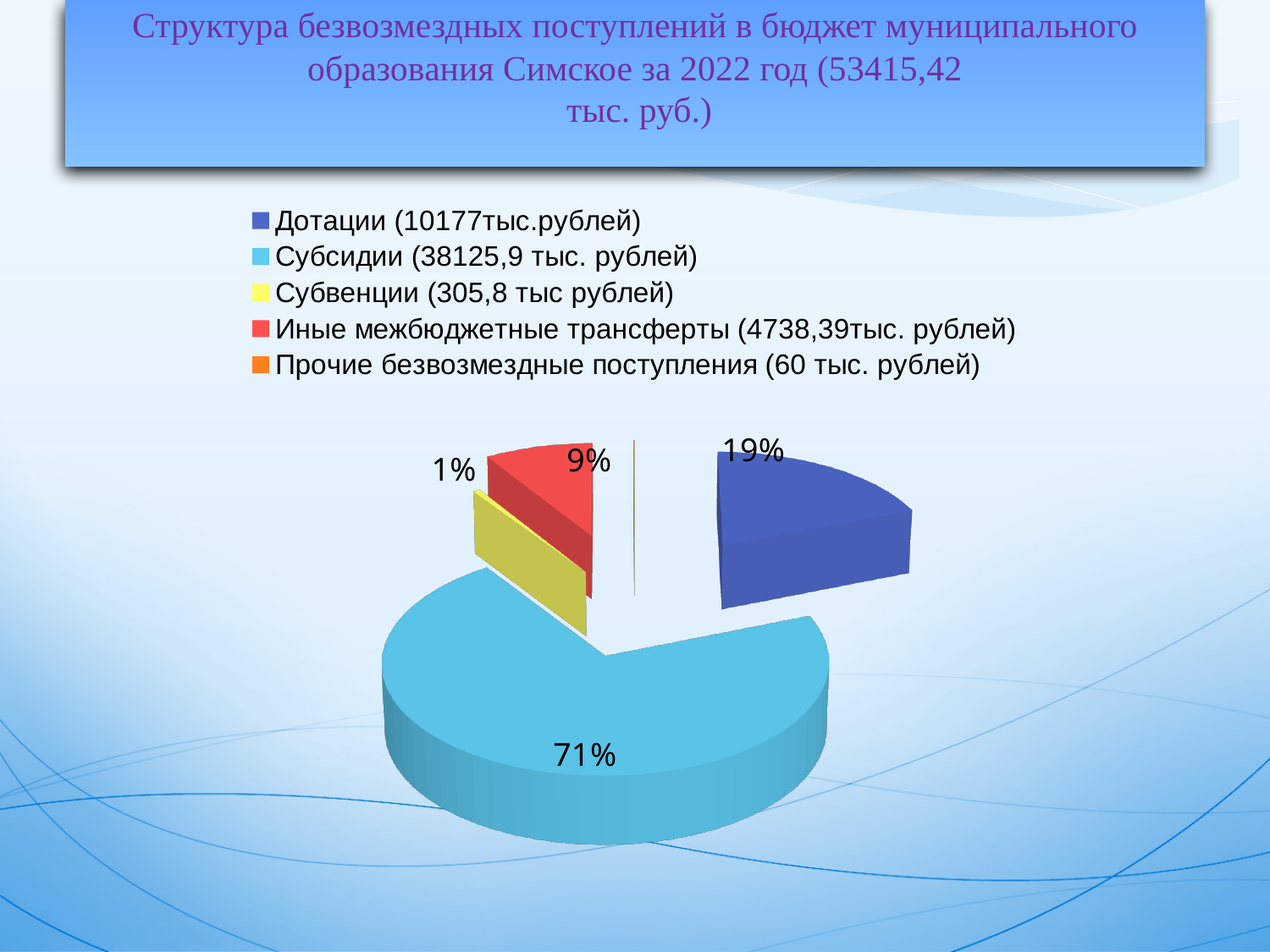
According to the legend, what amount in тыс. рублей corresponds to Субсидии? 38125,9 тыс. рублей What is the difference in percentage points between the Субсидии share and the Дотации share? 52% Which is larger, the share for Дотации or the share for Иные межбюджетные трансферты? Дотации What share of the pie does Дотации account for? 19% What kind of chart is shown on the slide? Pie chart What share of the pie does Субсидии account for? 71% How many categories does the legend list? 5 What total amount is given in the chart title for 2022? 53415,42 тыс. руб. What share of the pie does Субвенции account for? 1% Which category has the smallest value according to the legend? Прочие безвозмездные поступления Which category has the largest slice of the pie? Субсидии